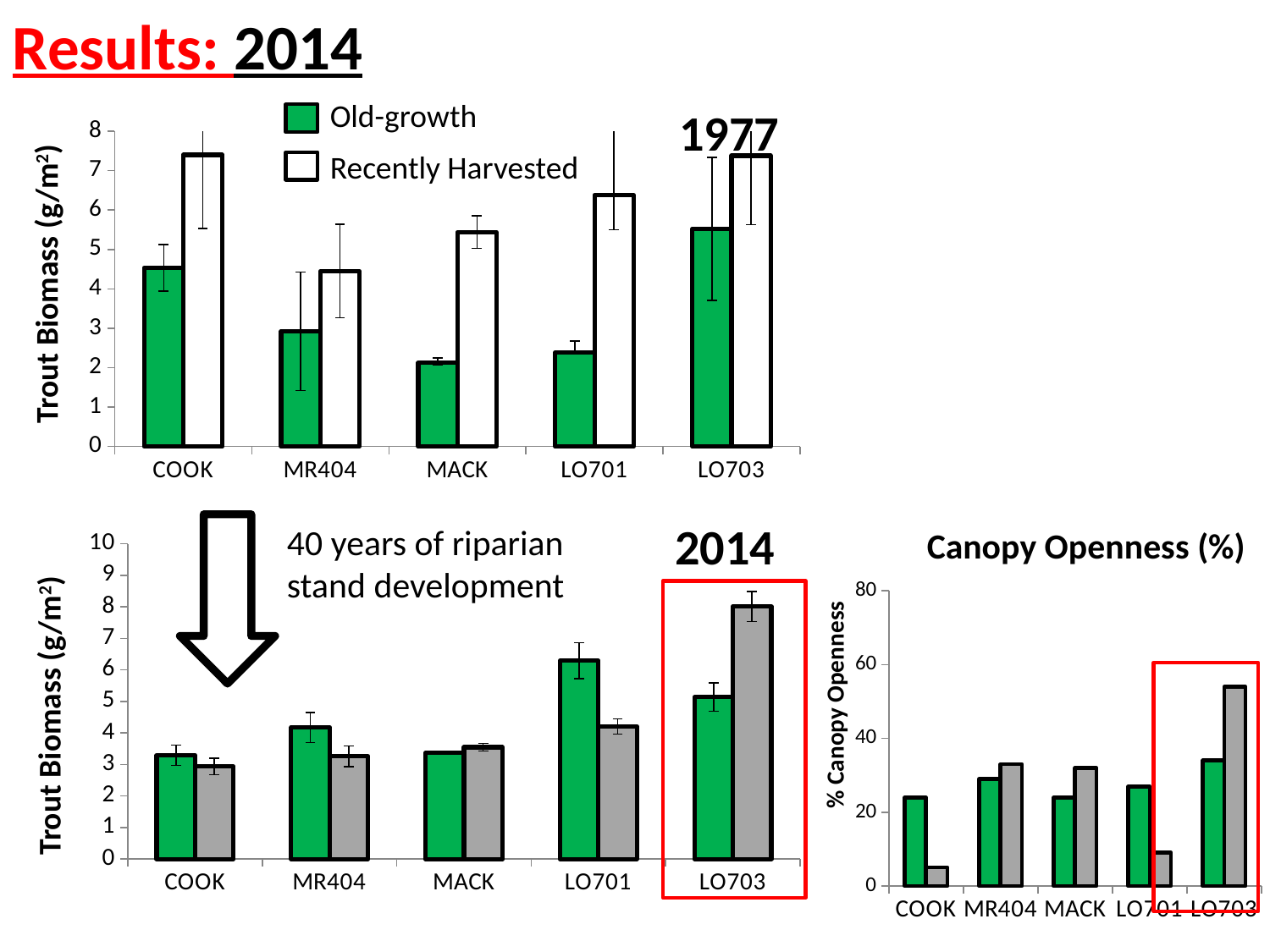
How many series does the legend on the 1977 Trout Biomass chart list? 2 What kind of chart is the 1977 Trout Biomass chart? bar chart In the 2014 Trout Biomass chart, which site has the highest Old-growth (green) value? LO701 In the 1977 Trout Biomass chart, which site has the highest Old-growth value? LO703 In the Canopy Openness (%) chart, is the gray bar for COOK greater or less than 20? less In the Canopy Openness (%) chart, which site has the highest gray bar? LO703 In the 1977 Trout Biomass chart, is the Recently Harvested value for COOK greater or less than 7? greater In the 1977 Trout Biomass chart, is the Old-growth value for MACK greater or less than 3? less In the 2014 Trout Biomass chart, which is larger for LO701: the green bar or the gray bar? green bar How many sites are shown on the x axis of the 2014 Trout Biomass chart? 5 In the 1977 Trout Biomass chart, which is larger for LO701: the Old-growth bar or the Recently Harvested bar? Recently Harvested